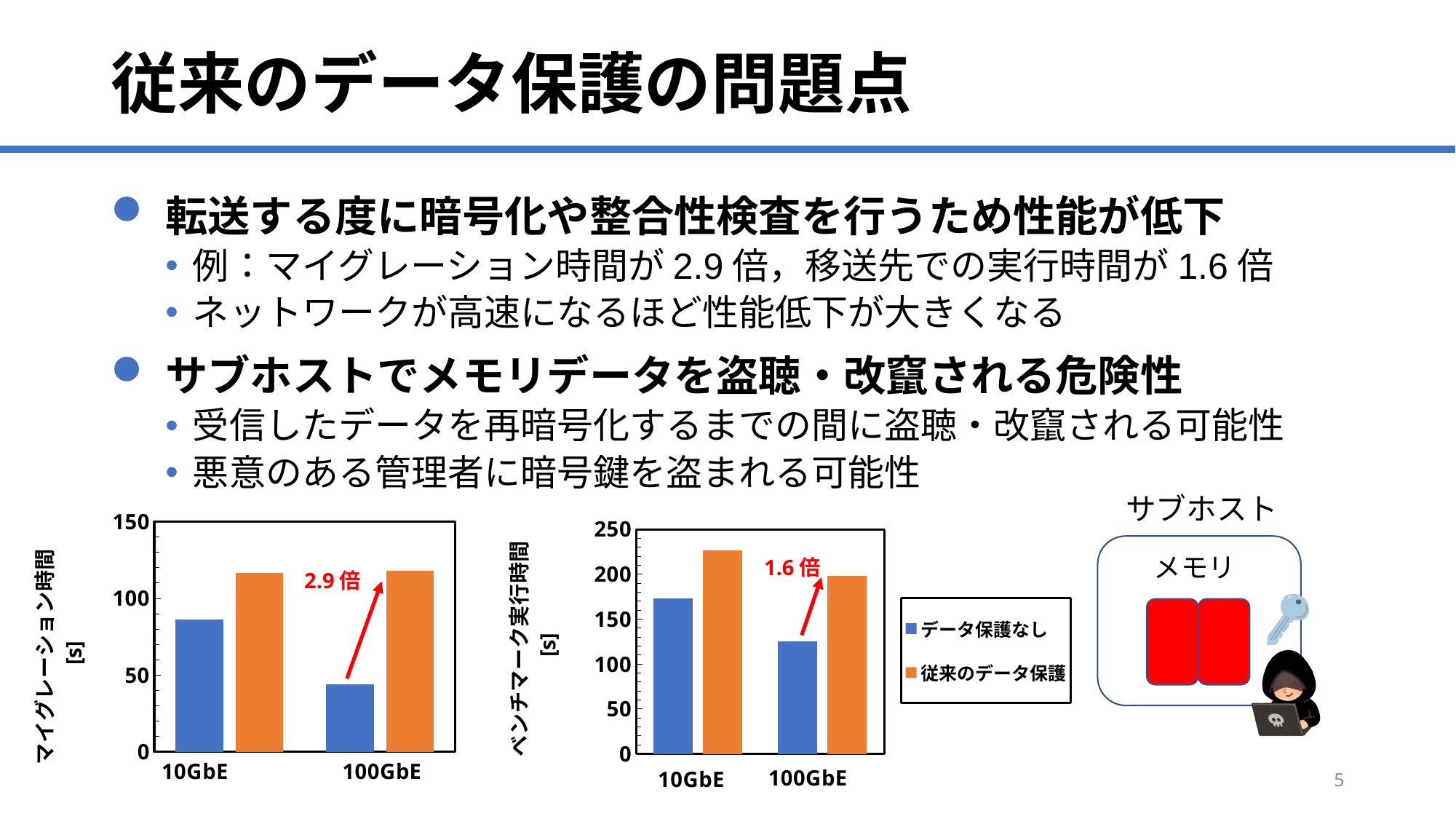
What ratio is annotated in red on the left chart (マイグレーション時間)? 2.9 倍 What kind of chart is the left chart (マイグレーション時間)? bar chart In the left chart (マイグレーション時間), does the value for データ保護なし rise or fall from 10GbE to 100GbE? fall In the left chart (マイグレーション時間), which series has the larger value at 100GbE, データ保護なし or 従来のデータ保護? 従来のデータ保護 In the right chart (ベンチマーク実行時間), which series has the larger value at 10GbE, データ保護なし or 従来のデータ保護? 従来のデータ保護 What is the y-axis label of the right chart? ベンチマーク実行時間 [s] In the left chart (マイグレーション時間), is the value for 従来のデータ保護 at 10GbE greater or less than 100? greater How many series does the legend list for the charts? 2 In the right chart (ベンチマーク実行時間), is the value for 従来のデータ保護 at 10GbE greater or less than 200? greater In the left chart (マイグレーション時間), is the value for データ保護なし at 100GbE greater or less than 50? less How many categories are shown on the x axis of the left chart (マイグレーション時間)? 2